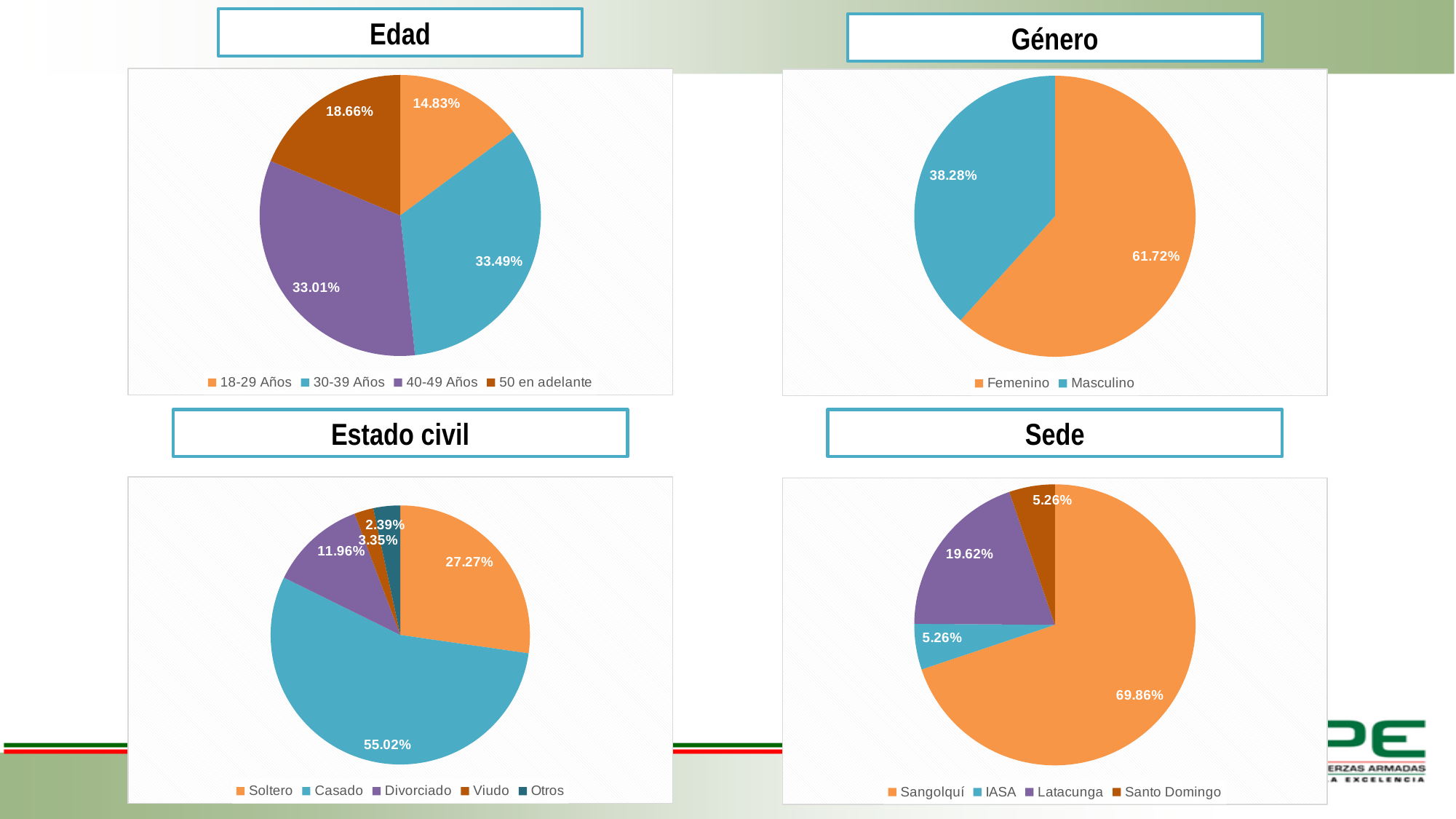
In the Sede chart, what is the difference between Sangolquí and Latacunga? 50.24% In the Sede chart, what percentage is Latacunga? 19.62% What type of chart is used for Género? Pie chart In the Edad chart, what is the difference between the 50 en adelante share and the 18-29 Años share? 3.83% In the Estado civil chart, what percentage is Casado? 55.02% In the Género chart, which is larger, Femenino or Masculino? Femenino In the Estado civil chart, which category has the largest share? Casado In the Sede chart, what colour is the Sangolquí slice? Orange In the Edad chart, which age group has the smallest share? 18-29 Años In the Edad chart, what percentage is shown for 30-39 Años? 33.49% How many categories does the legend of the Estado civil chart list? 5 In the Género chart, what percentage is Femenino? 61.72%